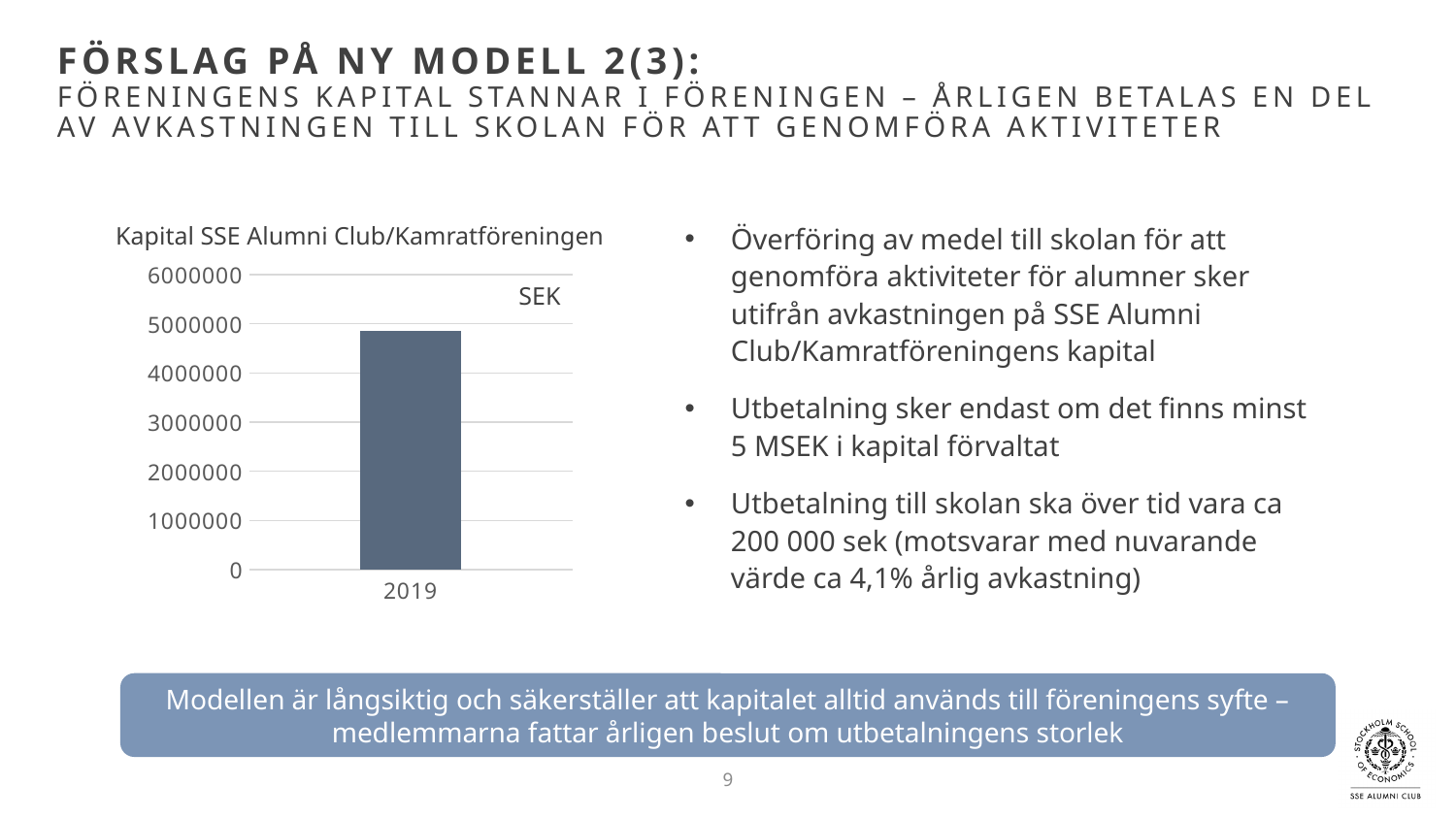
Is the value for 2019 greater or less than 5000000? less Which year is shown on the x axis of the chart? 2019 How many bars are plotted in the chart? 1 What kind of chart is shown on the slide? bar chart What is the title of the chart? Kapital SSE Alumni Club/Kamratföreningen Is the value for 2019 greater or less than 3000000? greater What series name is shown in the chart legend? SEK Is the value for 2019 greater or less than 4000000? greater How many series does the chart legend list? 1 What is the highest value shown on the chart's y axis? 6000000